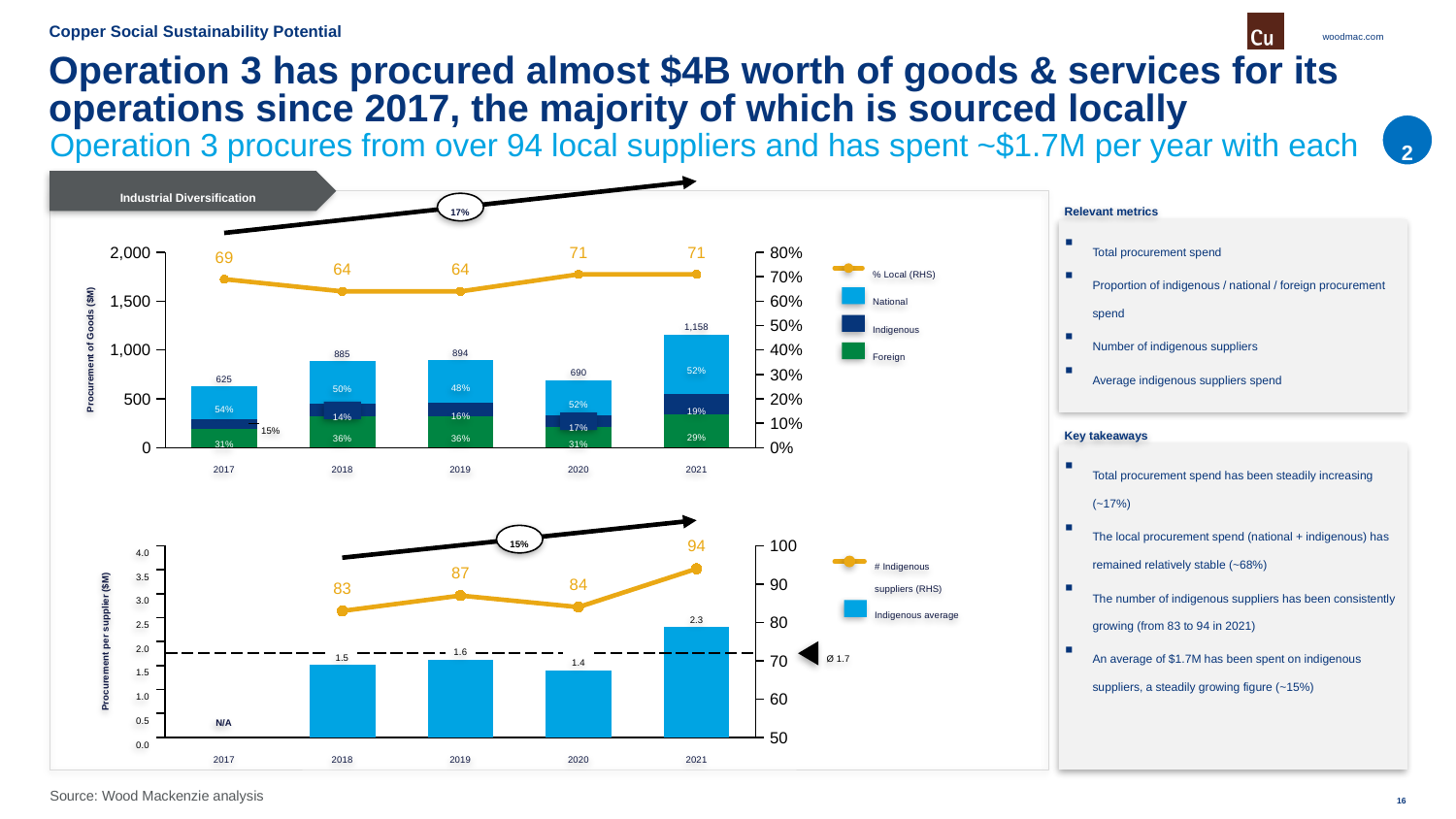
In the top chart, what is the difference in total procurement between 2021 and 2020? 468 In the top chart, which year has the highest total procurement of goods? 2021 In the bottom chart, what is the number of indigenous suppliers in 2019? 87 How many years are shown on the x axis of the bottom chart? 5 How many series does the legend of the top chart list? 4 In the top chart, which year has the lowest total procurement of goods? 2017 In the bottom chart, what is the Indigenous average procurement per supplier ($M) for 2021? 2.3 In the top chart, what share of the 2021 bar is National? 52% In the top chart, what is the total procurement of goods ($M) for 2021? 1,158 In the bottom chart, which year has the highest number of indigenous suppliers? 2021 In the top chart, what is the % Local value for 2018? 64 In the bottom chart, is the Indigenous average for 2019 or 2020 larger? 2019